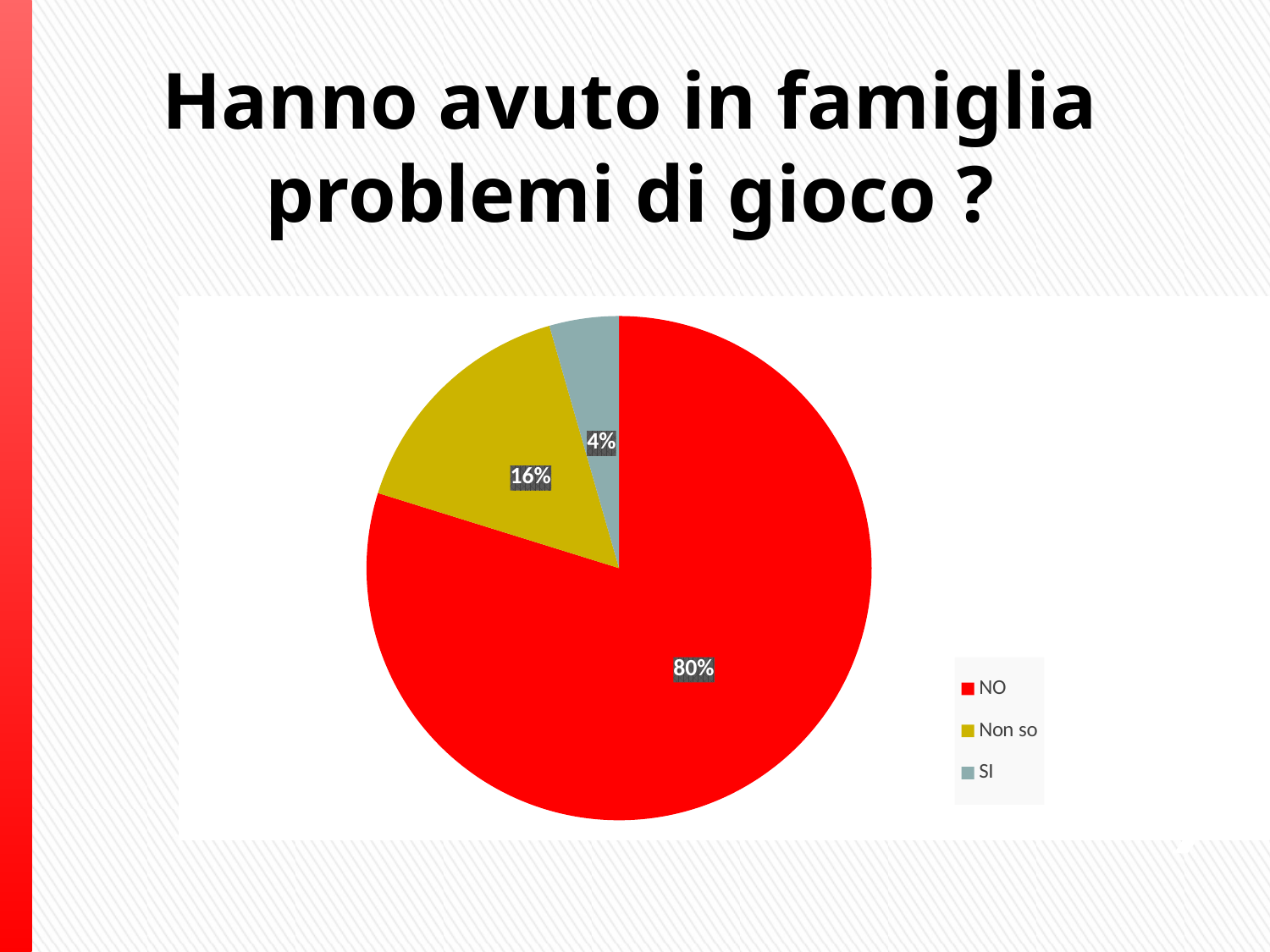
Which category has the smallest slice of the pie? SI How many entries does the legend list? 3 What percentage of the pie is labelled Non so? 16% How many slices does the pie chart have? 3 Which category has the largest slice of the pie? NO What percentage of the pie is labelled SI? 4% What colour is the NO slice in the pie chart? red What kind of chart is shown on the slide? pie chart What percentage of the pie is labelled NO? 80% What is the difference in percentage points between the Non so slice and the SI slice? 12 Which slice is larger, Non so or SI? Non so What is the difference in percentage points between the NO slice and the Non so slice? 64